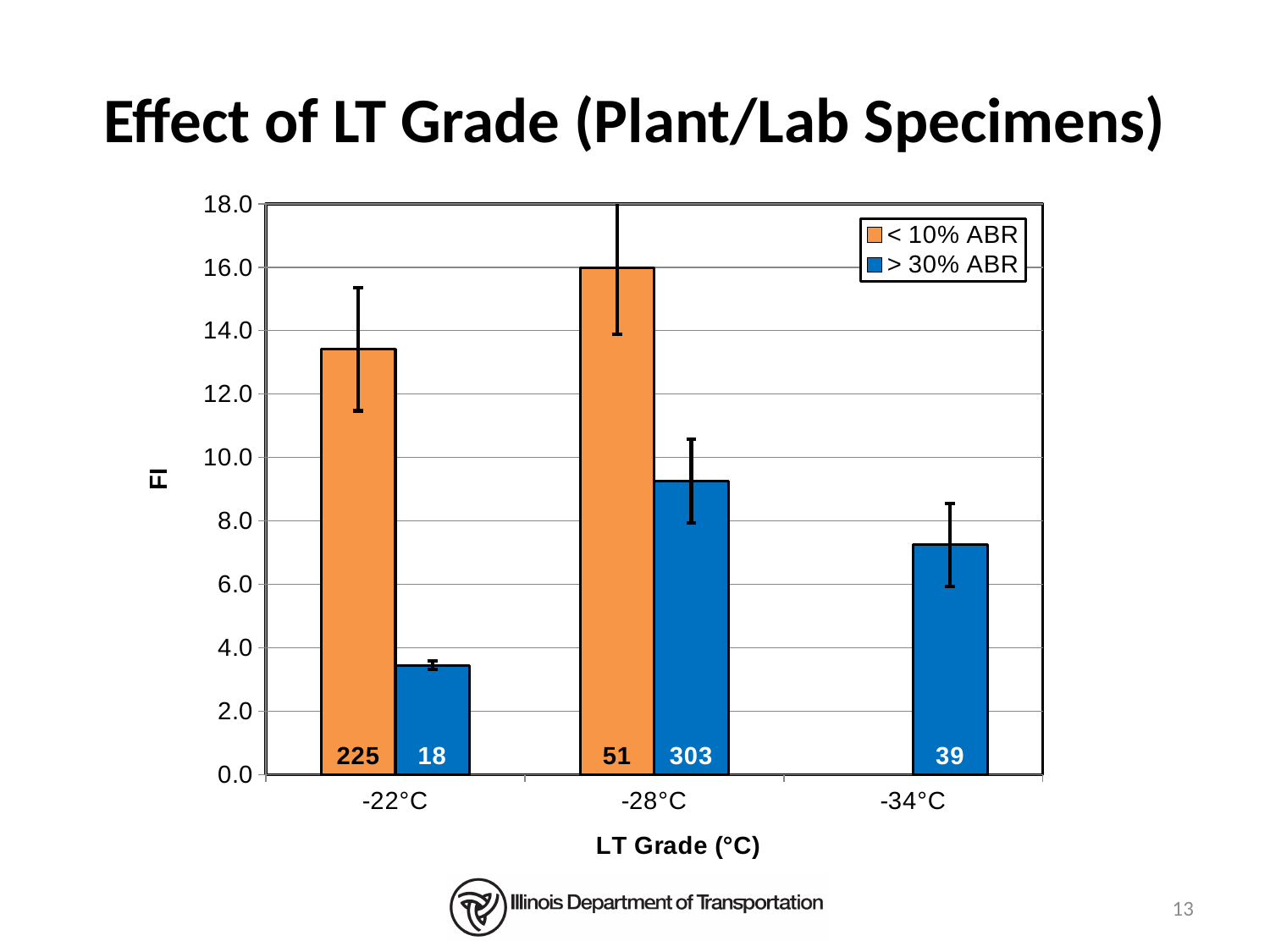
Which bar is the highest in the chart? < 10% ABR at -28°C What is the label on the y axis? FI Is the FI value for < 10% ABR at -22°C greater or less than 12.0? greater How many series does the legend list? 2 What number is printed at the base of the > 30% ABR bar at -28°C? 303 Is the FI value for > 30% ABR at -22°C greater or less than 4.0? less At -28°C, which series has the larger FI value, < 10% ABR or > 30% ABR? < 10% ABR What kind of chart is shown on the slide? bar chart Is the FI value for > 30% ABR at -34°C greater or less than 8.0? less Which bar is the lowest in the chart? > 30% ABR at -22°C Does the FI value for > 30% ABR rise or fall from -22°C to -28°C? rise How many LT Grade categories are shown on the x axis? 3